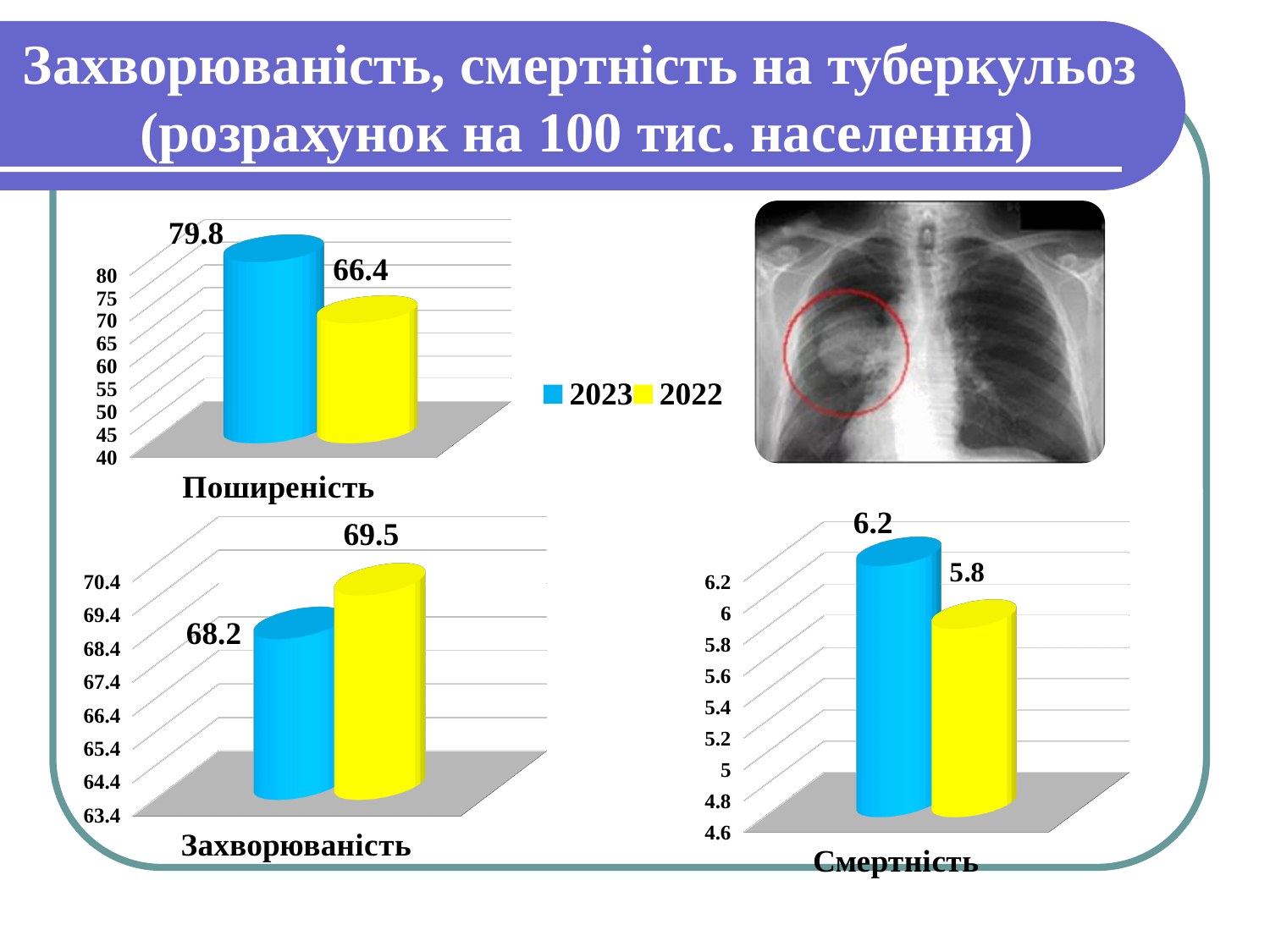
In the "Смертність" chart, which year has the lower value? 2022 What type of chart is the "Поширеність" chart? bar chart In the "Поширеність" chart, what is the value for 2023? 79.8 In the "Поширеність" chart, what is the difference between the 2023 and 2022 values? 13.4 In the "Поширеність" chart, what is the value for 2022? 66.4 Which colour represents 2023 in the legend? blue In the "Захворюваність" chart, which year has the higher value, 2023 or 2022? 2022 In the "Захворюваність" chart, what is the difference between the 2022 and 2023 values? 1.3 How many series does the legend list? 2 In the "Смертність" chart, is the value for 2022 greater or less than 6? less In the "Захворюваність" chart, what is the value for 2022? 69.5 In the "Смертність" chart, what is the value for 2023? 6.2